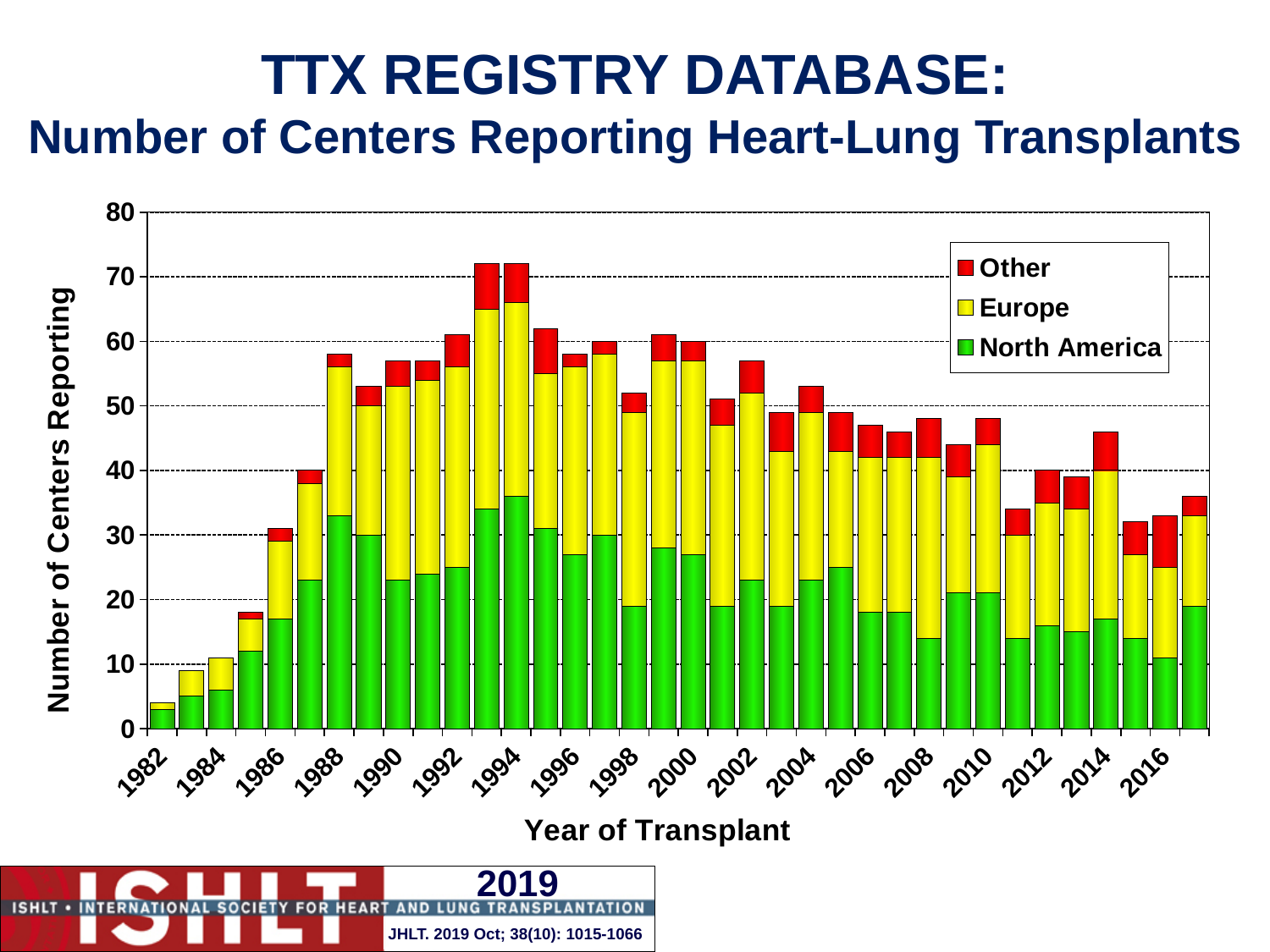
Which series are listed in the legend? Other, Europe, North America What is the title of the y axis? Number of Centers Reporting Does the total number of centers reporting rise or fall from 1982 to 1988? rise Which year has the lowest total number of centers reporting? 1982 Is the total number of centers reporting in 1982 greater or less than 10? less Is the total number of centers reporting in 1993 greater or less than 70? greater What kind of chart is shown on the slide? Stacked bar chart Is the number of North America centers reporting in 1994 greater or less than 30? greater How many series does the legend list? 3 Which year has a higher total number of centers reporting, 1990 or 2012? 1990